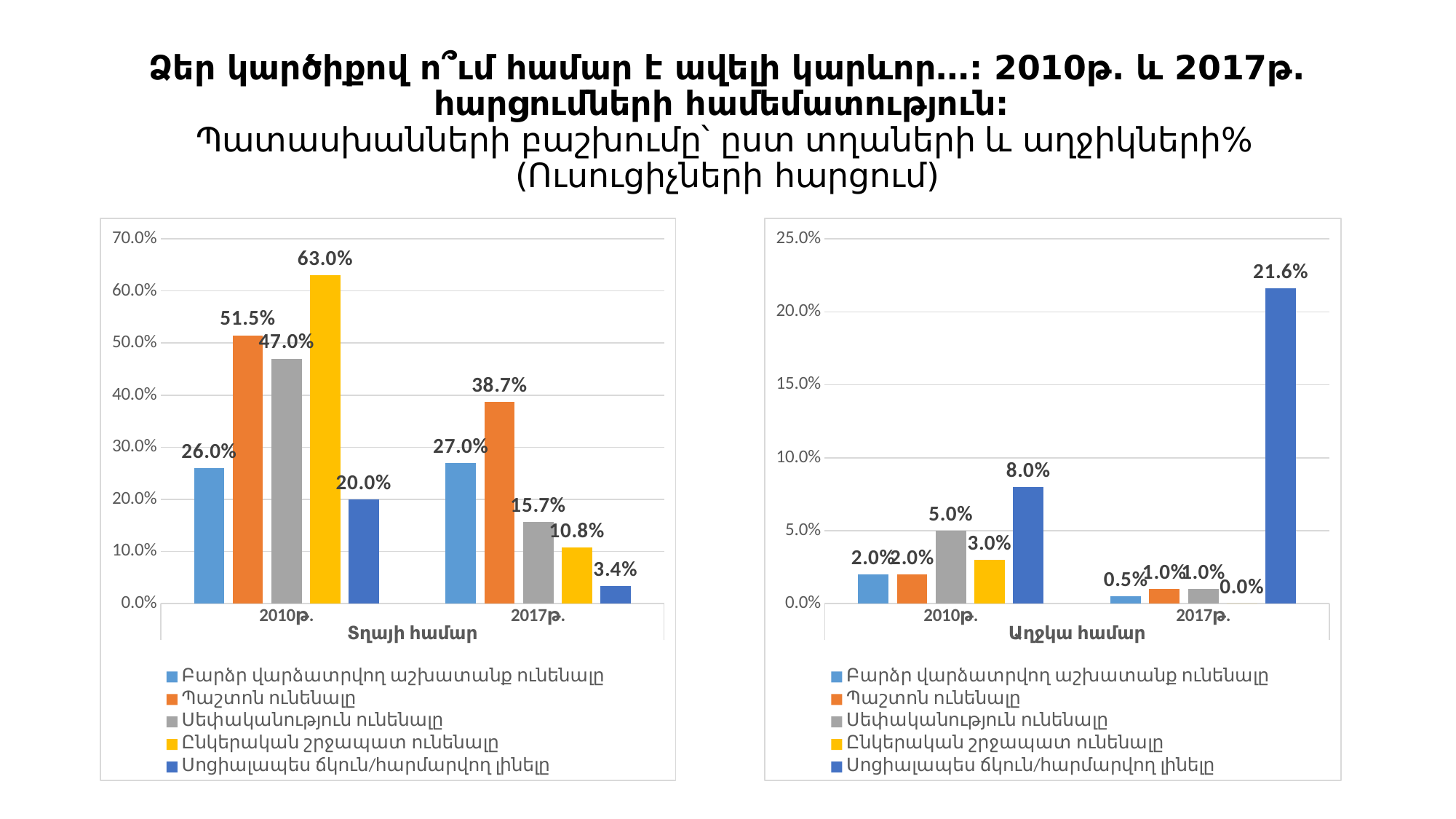
In the right chart (Աղջկա համար), what is the value for Սեփականություն ունենալը in 2010թ.? 5.0% In the right chart (Աղջկա համար), what is the value for Սոցիալապես ճկուն/հարմարվող լինելը in 2017թ.? 21.6% In the left chart (Տղայի համար), what is the value for Պաշտոն ունենալը in 2017թ.? 38.7% What kind of chart is the left chart (Տղայի համար)? Bar chart In the left chart (Տղայի համար), what is the value for Ընկերական շրջապատ ունենալը in 2010թ.? 63.0% In the left chart (Տղայի համար), what is the difference between the 2010թ. and 2017թ. values for Ընկերական շրջապատ ունենալը? 52.2% In the left chart (Տղայի համար), is the value for Բարձր վարձատրվող աշխատանք ունենալը larger in 2010թ. or in 2017թ.? 2017թ. How many series does the legend of the right chart (Աղջկա համար) list? 5 In the left chart (Տղայի համար), which series has the lowest value in 2017թ.? Սոցիալապես ճկուն/հարմարվող լինելը In the right chart (Աղջկա համար), which series has the lowest value in 2017թ.? Ընկերական շրջապատ ունենալը In the right chart (Աղջկա համար), what is the difference between the 2017թ. and 2010թ. values for Սոցիալապես ճկուն/հարմարվող լինելը? 13.6% In the left chart (Տղայի համար), which series has the highest value in 2010թ.? Ընկերական շրջապատ ունենալը